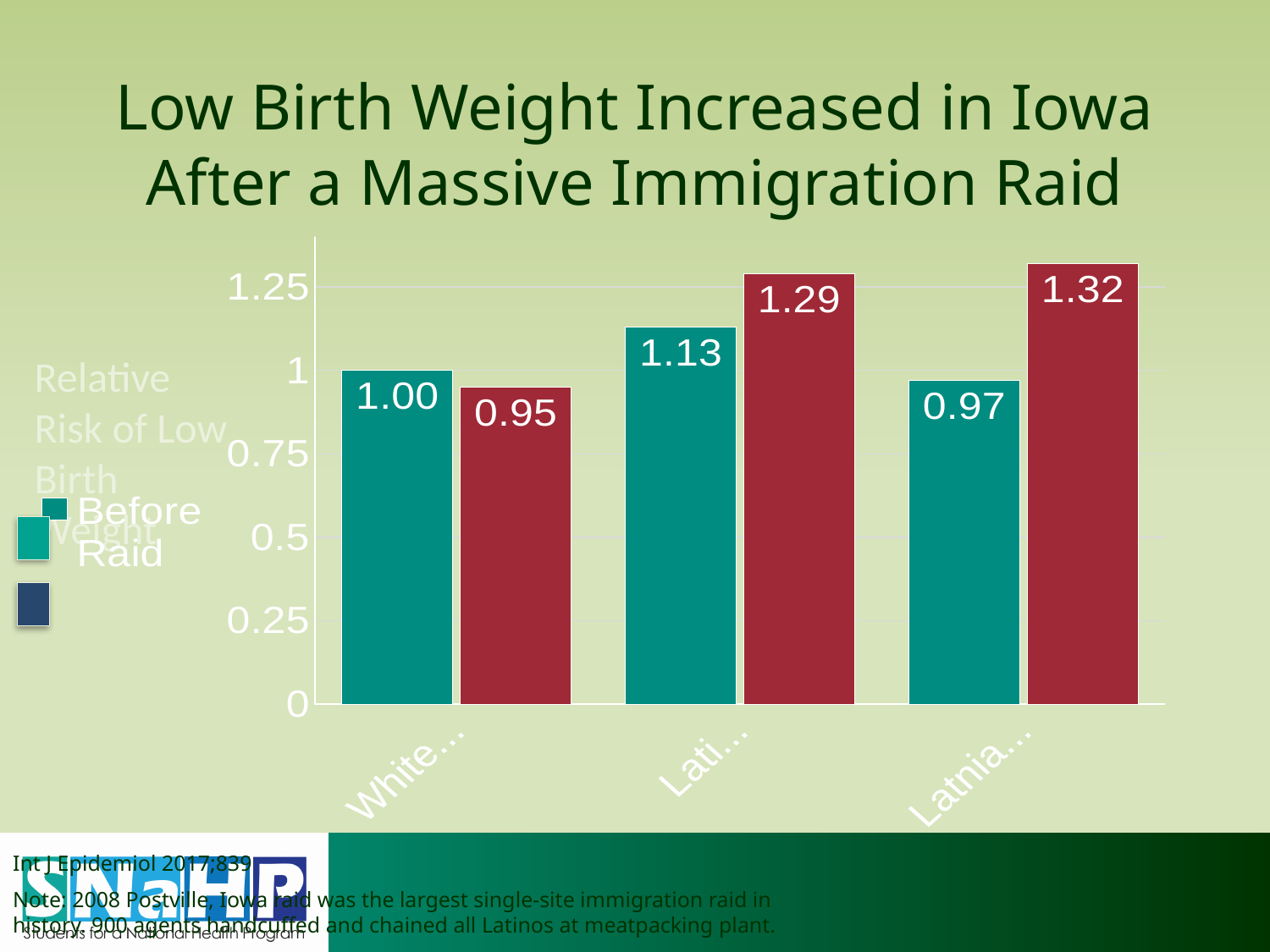
What is the Before Raid relative risk value for the White group? 1.00 For the White group, which is larger: the Before Raid bar or the red bar? Before Raid What is the Before Raid value for the third category group (labelled "Latnia...")? 0.97 In the third category group, what is the difference between the red bar and the Before Raid bar? 0.35 What is the Before Raid value for the second category group (labelled "Lati...")? 1.13 How many category groups are shown on the x axis? 3 What is the value of the red bar in the third category group (labelled "Latnia...")? 1.32 What is the lowest relative risk value shown on the chart? 0.95 What is the value of the red bar for the White group? 0.95 Which bar shows the highest relative risk on the chart? The red bar in the third group (1.32) What type of chart is shown on the slide? Bar chart What is the value of the red bar in the second category group (labelled "Lati...")? 1.29